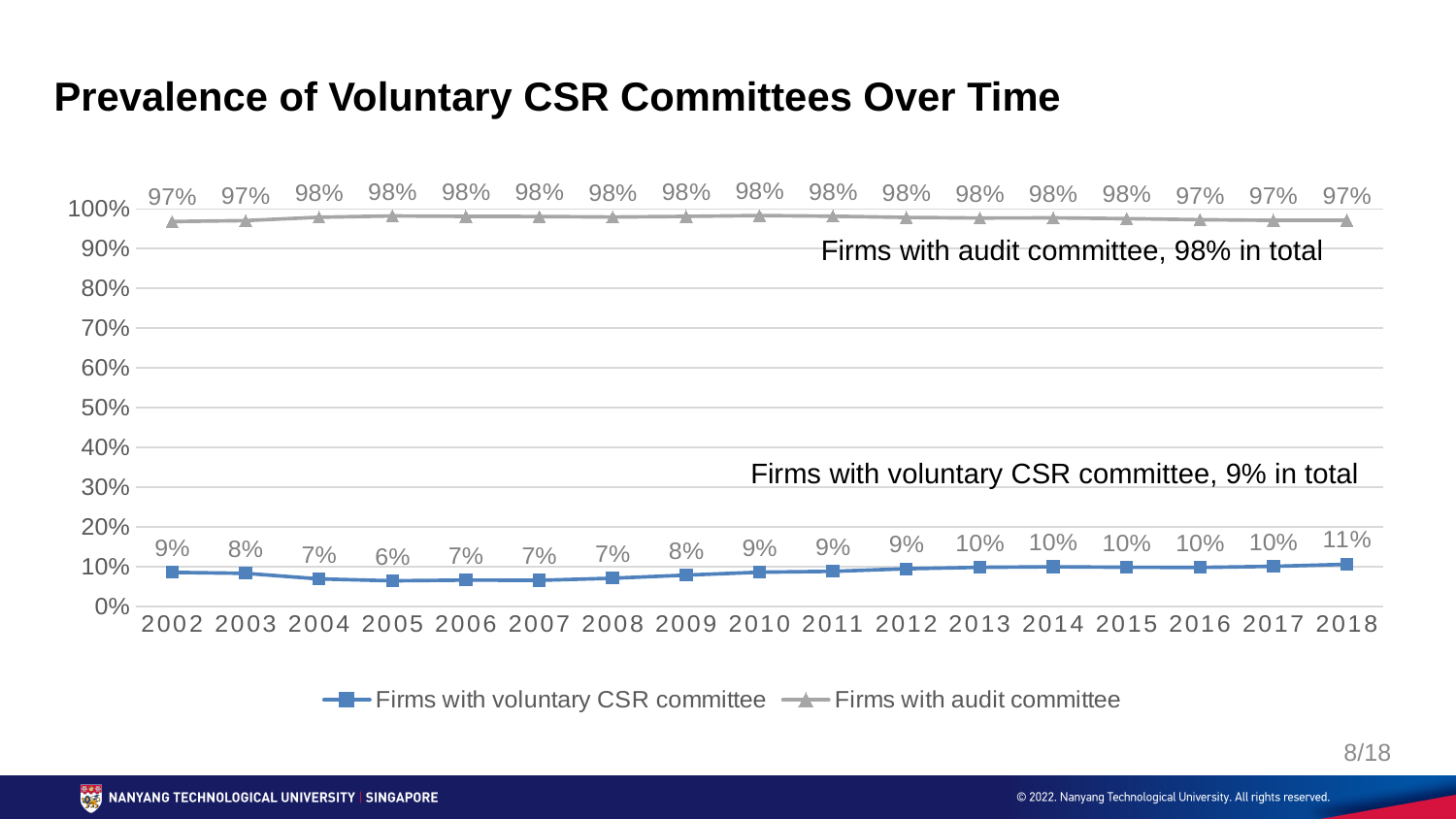
How many years are plotted on the x axis? 17 Which is larger for Firms with voluntary CSR committee: the value in 2003 or the value in 2013? 2013 What is the value for Firms with voluntary CSR committee in 2005? 6% In which year is the value for Firms with voluntary CSR committee the lowest? 2005 What kind of chart is shown on the slide? Line chart What is the value for Firms with audit committee in 2010? 98% What is the difference between the Firms with voluntary CSR committee values in 2018 and 2005? 5% Does the value for Firms with voluntary CSR committee rise or fall from 2005 to 2018? Rise What is the title of the chart? Prevalence of Voluntary CSR Committees Over Time How many series does the legend list? 2 What is the value for Firms with voluntary CSR committee in 2018? 11% In which year is the value for Firms with voluntary CSR committee the highest? 2018